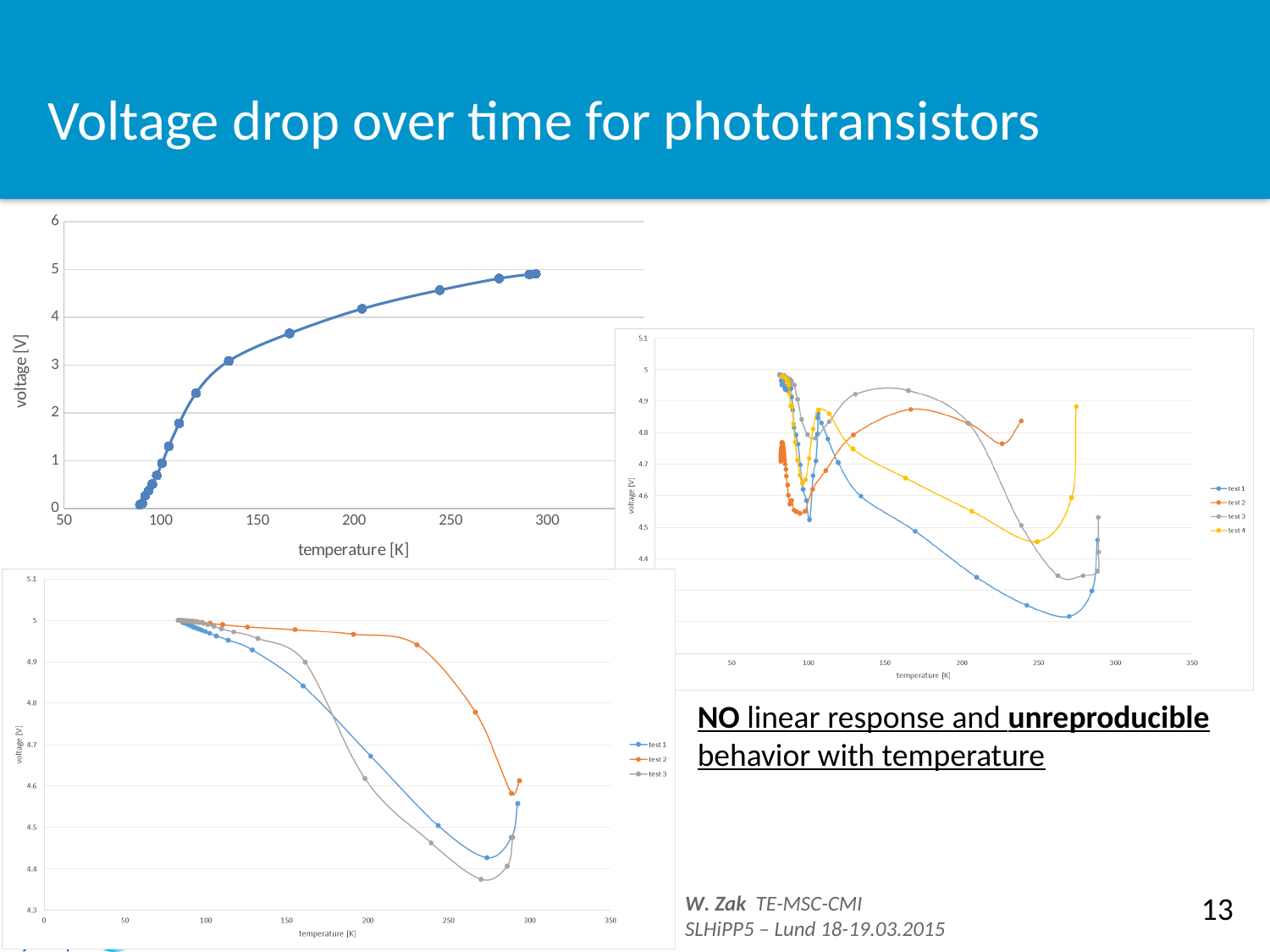
In the right-hand chart, is the value of test 4 at about 250 K greater or less than 4.6? less In the top-left chart, do the voltage values rise or fall as temperature increases along the x axis? rise In the right-hand chart, which series reaches the lowest voltage? test 1 How many series does the legend of the right-hand chart list? 4 In the top-left chart, is the voltage at about 250 K greater or less than 5? less What kind of chart is the top-left chart on the slide? line chart In the bottom-left chart, which series reaches the lowest voltage? test 3 In the bottom-left chart, is the value of test 2 at about 200 K greater or less than 4.9? greater What is the x-axis label of the top-left chart? temperature [K] How many series does the legend of the bottom-left chart list? 3